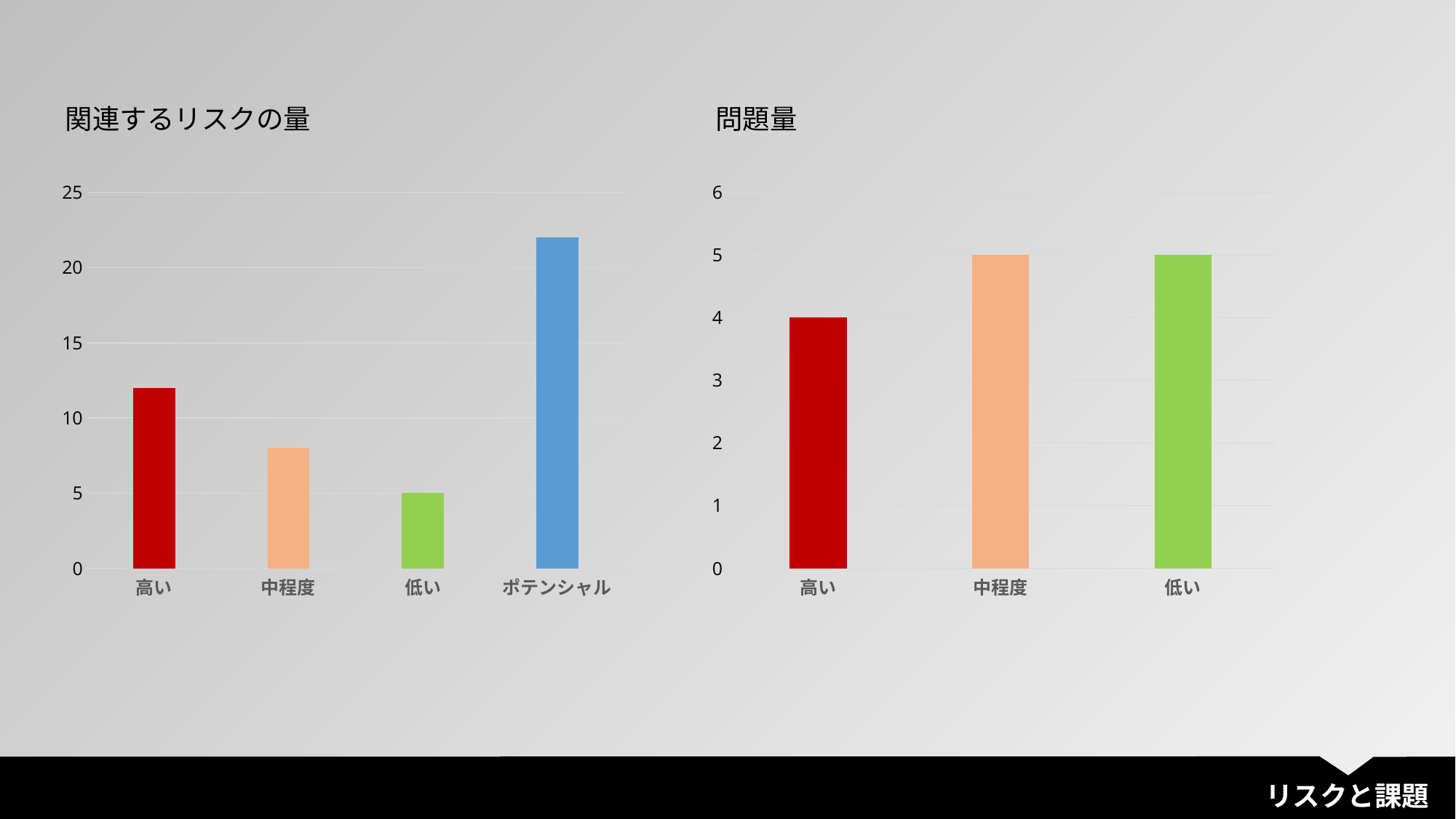
In the 問題量 chart, what is the difference between the values for 中程度 and 高い? 1 What kind of chart is the 問題量 chart? Bar chart In the 関連するリスクの量 chart, what is the value for 低い? 5 In the 関連するリスクの量 chart, which category has the highest value? ポテンシャル In the 関連するリスクの量 chart, is the value for 中程度 greater or less than 10? less In the 問題量 chart, what is the value for 中程度? 5 In the 問題量 chart, which category has the lowest value? 高い In the 関連するリスクの量 chart, is the value for 高い greater or less than 10? greater In the 問題量 chart, what is the value for 高い? 4 In the 関連するリスクの量 chart, how many categories are shown? 4 In the 関連するリスクの量 chart, which category has the lowest value? 低い In the 関連するリスクの量 chart, is the value for ポテンシャル greater or less than 20? greater